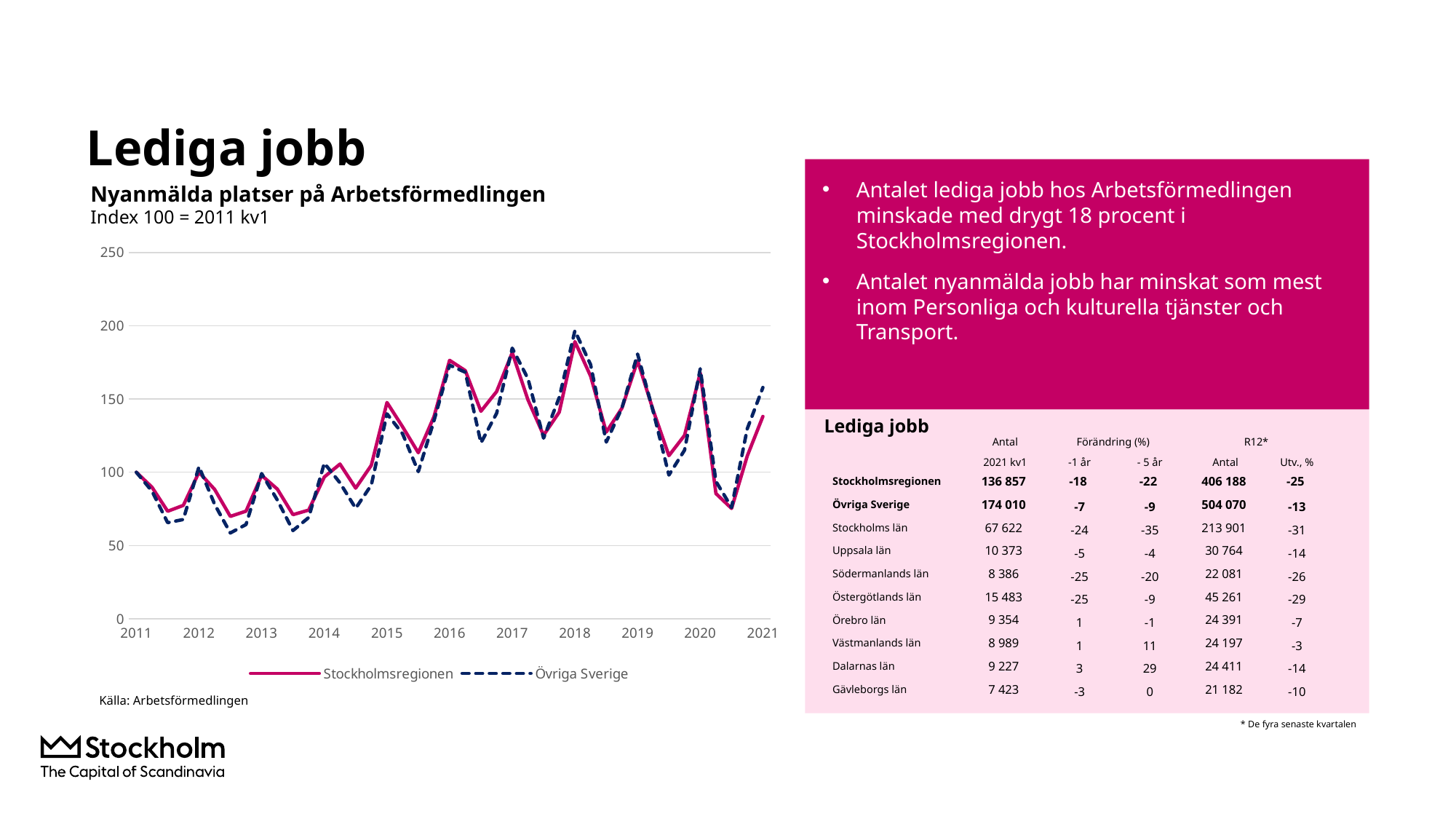
How many years are labelled on the x axis of the chart? 11 Do the values for Stockholmsregionen generally rise or fall between 2014 and 2018? rise What is the title of the chart? Nyanmälda platser på Arbetsförmedlingen What is the index value for Stockholmsregionen at the start of 2011 (2011 kv1)? 100 What kind of chart is shown on the slide? line chart How many series does the chart legend list? 2 At 2021, which series has the higher value, Stockholmsregionen or Övriga Sverige? Övriga Sverige Is the peak value for Stockholmsregionen in 2018 greater or less than 150? greater In which year does the Övriga Sverige series reach its highest value? 2018 Which two series are shown in the chart legend? Stockholmsregionen and Övriga Sverige Is the value for Övriga Sverige at 2021 greater or less than 150? greater Is the value for Stockholmsregionen at 2021 greater or less than 150? less